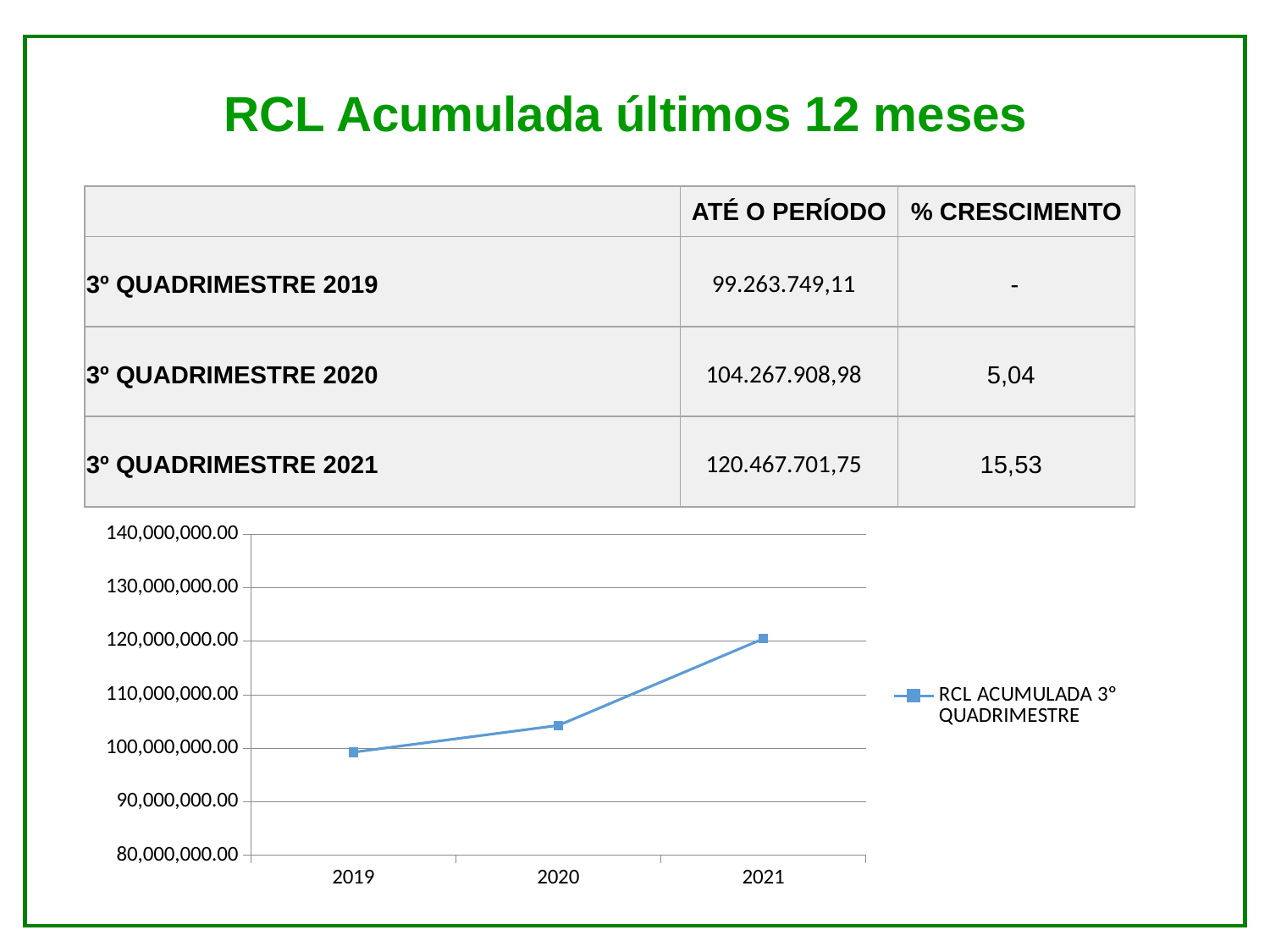
Is the value for 2021 in the line chart greater or less than 110,000,000.00? greater Which is larger in the line chart, the value for 2020 or the value for 2021? 2021 How many series does the chart legend list? 1 Is the value for 2020 in the line chart greater or less than 110,000,000.00? less Which year has the lowest value in the line chart? 2019 What is the name of the series shown in the chart legend? RCL ACUMULADA 3° QUADRIMESTRE Is the value for 2019 in the line chart greater or less than 100,000,000.00? less According to the table, what is the RCL accumulated value for 3º QUADRIMESTRE 2021? 120.467.701,75 Which year has the highest value in the line chart? 2021 How many data points are plotted on the line chart? 3 What kind of chart is shown on the slide? line chart Do the values in the line chart rise or fall from 2019 to 2021? rise